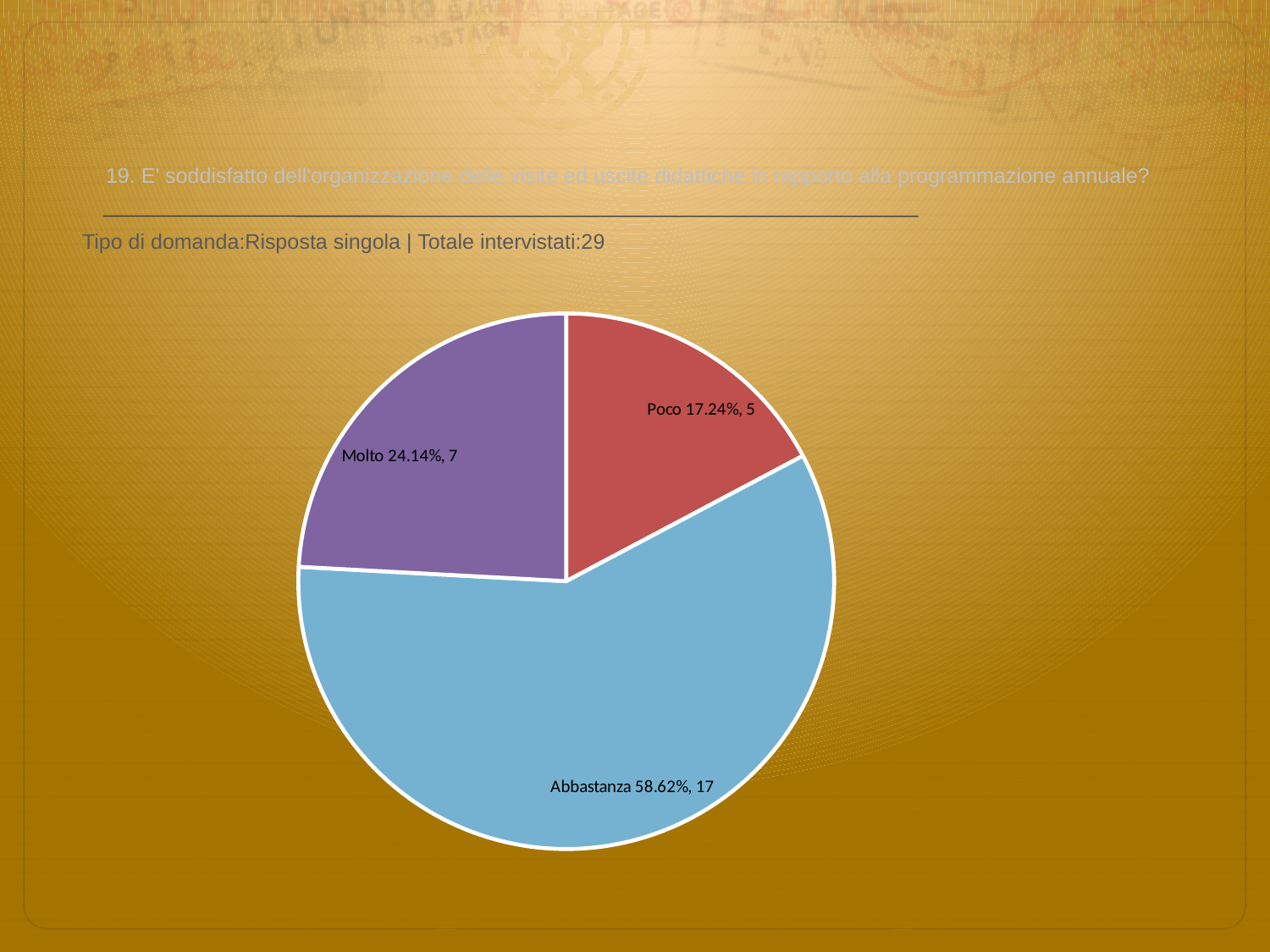
What percentage share does the Molto slice have? 24.14% How many respondents answered Molto? 7 What is the difference in respondent count between Abbastanza and Molto? 10 What percentage share does the Abbastanza slice have? 58.62% What kind of chart is shown on the slide? pie chart How many slices does the pie chart have? 3 How many respondents answered Poco? 5 How many respondents answered Abbastanza? 17 Which response category has the largest slice? Abbastanza Which response category has the smallest slice? Poco Which slice is larger, Molto or Poco? Molto What percentage share does the Poco slice have? 17.24%